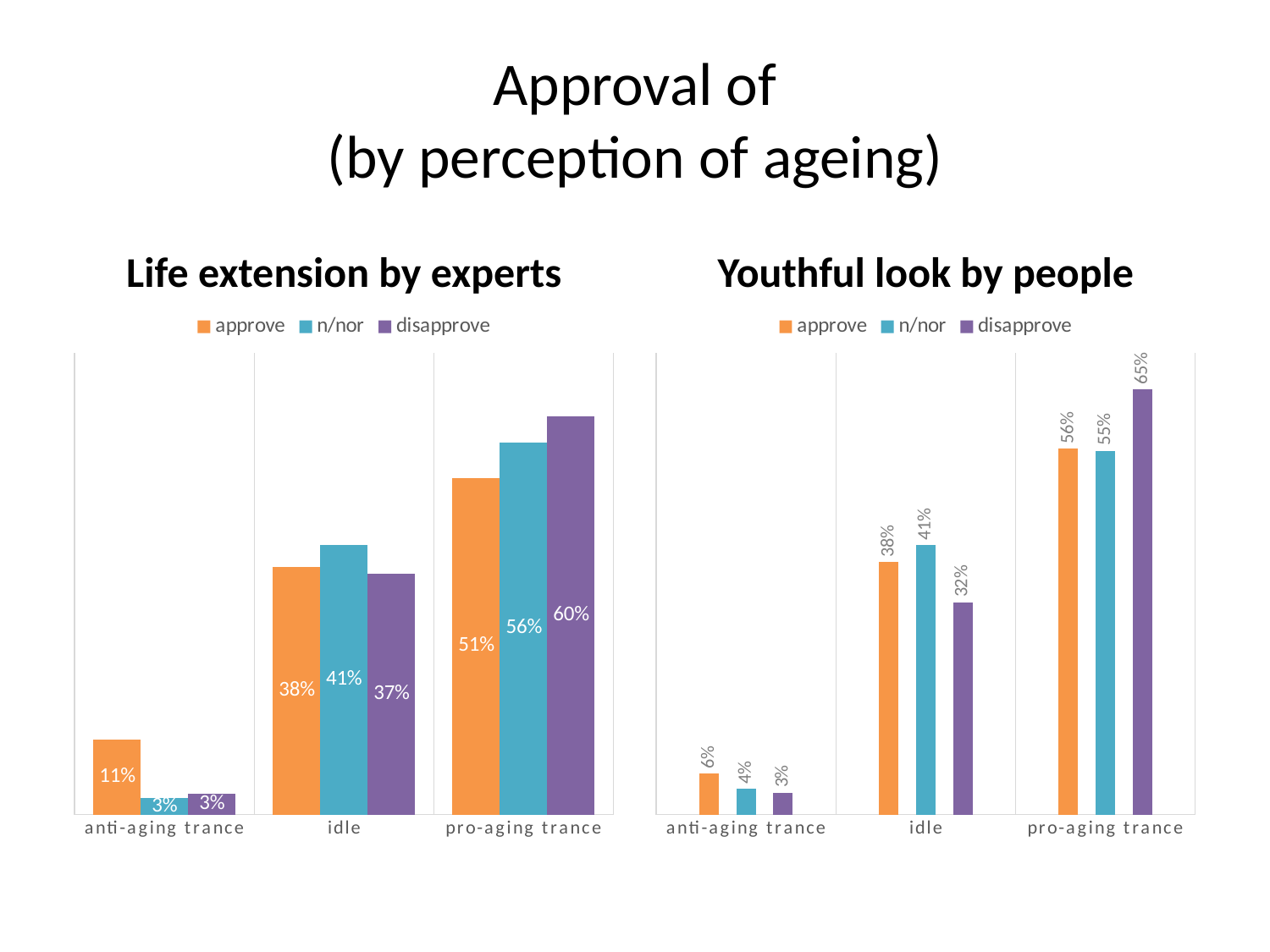
How many categories are shown on the x axis of the 'Life extension by experts' chart? 3 In the 'Life extension by experts' chart, what is the difference between the disapprove and approve values for pro-aging trance? 9% In the 'Youthful look by people' chart, which is larger for pro-aging trance: approve or disapprove? disapprove In the 'Life extension by experts' chart, what is the approve value for idle? 38% In the 'Life extension by experts' chart, what is the disapprove value for pro-aging trance? 60% In the 'Life extension by experts' chart, which category has the lowest approve value? anti-aging trance In the 'Youthful look by people' chart, which category has the highest disapprove value? pro-aging trance What kind of chart is the 'Life extension by experts' chart? bar chart In the 'Youthful look by people' chart, what is the n/nor value for idle? 41% In the 'Youthful look by people' chart, what is the difference between the approve and disapprove values for idle? 6% In the 'Youthful look by people' chart, what is the approve value for anti-aging trance? 6% How many series does the legend of the 'Youthful look by people' chart list? 3